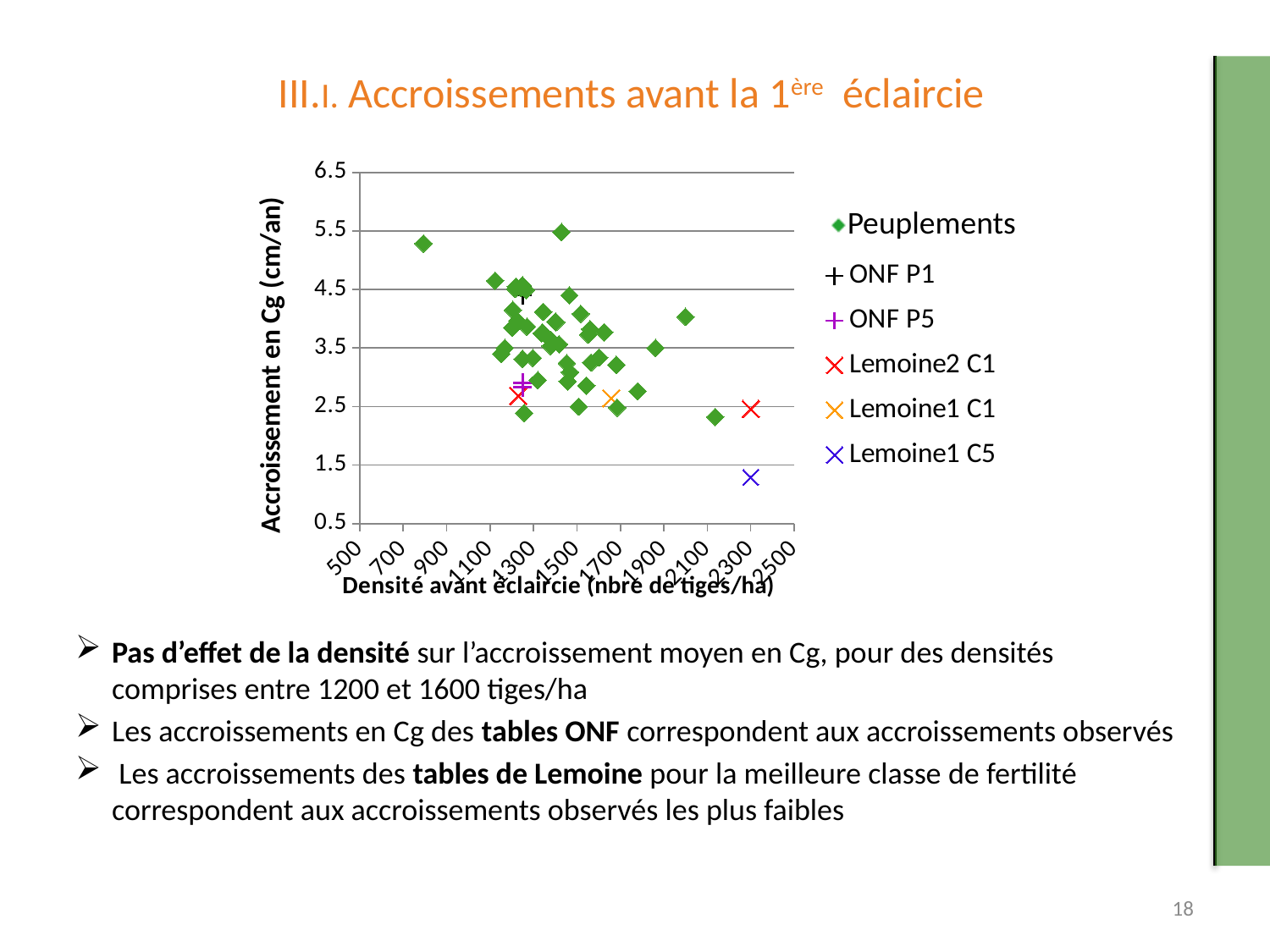
Is the value for ONF P5 greater or less than 3.5? less What is the title of the chart's horizontal axis? Densité avant éclaircie (nbre de tiges/ha) Is the value for Lemoine1 C1 greater or less than 3.5? less Is the value for Lemoine1 C5 greater or less than 1.5? less Which has the higher accroissement value, Lemoine2 C1 or Lemoine1 C5? Lemoine2 C1 How many series does the chart legend list? 6 Which series has the lowest accroissement value on the chart? Lemoine1 C5 What is the title of the chart's vertical axis? Accroissement en Cg (cm/an) Which has the higher accroissement value, ONF P1 or ONF P5? ONF P1 What kind of chart is shown on the slide? scatter chart